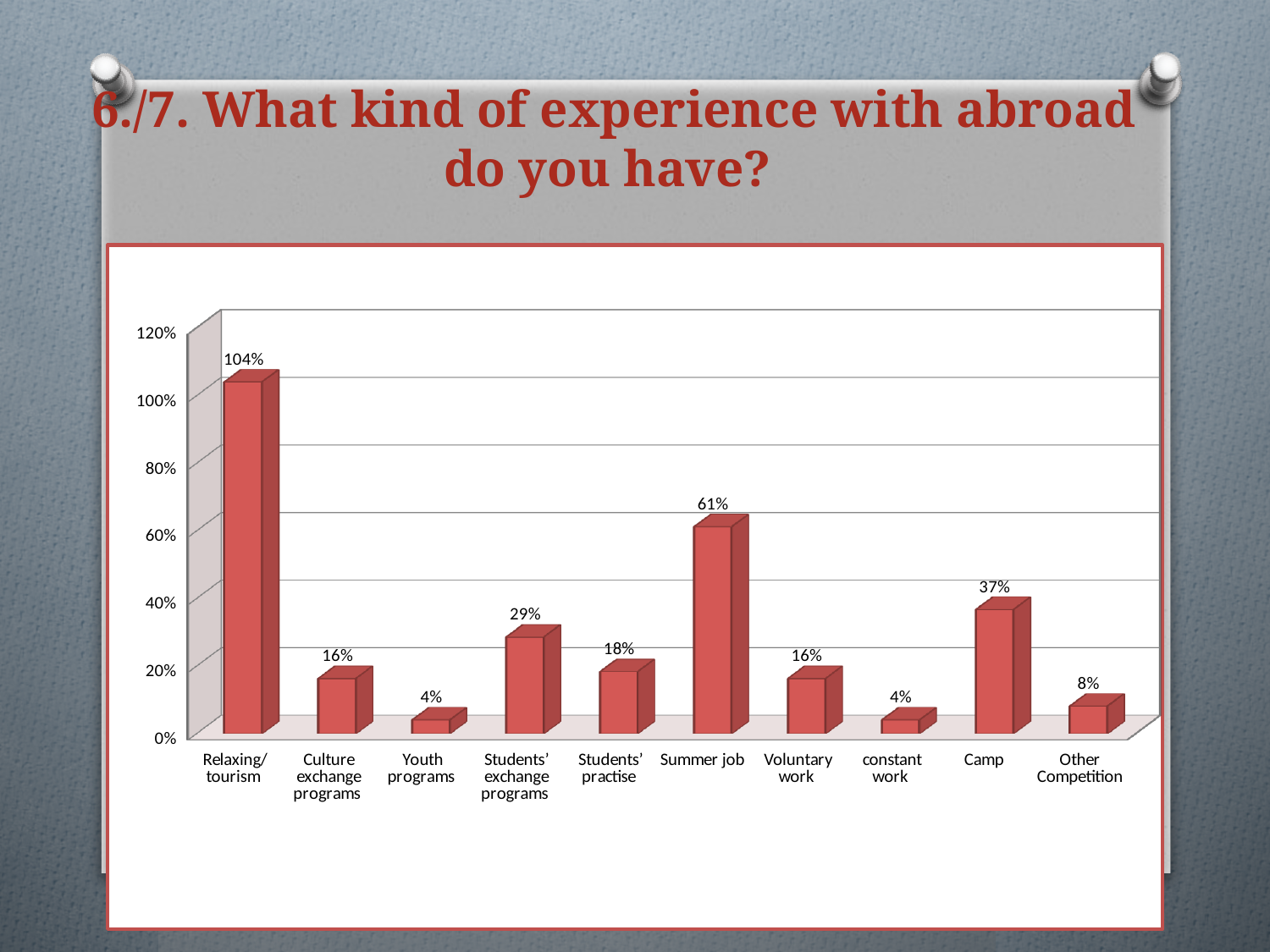
What is the difference between the values for Students' exchange programs and Students' practise? 11% Which category has the highest value? Relaxing/tourism What is the value for Relaxing/tourism? 104% What is the difference between the values for Summer job and Camp? 24% What is the value for Summer job? 61% Which is larger, the value for Culture exchange programs or the value for Students' practise? Students' practise How many categories are shown on the x axis? 10 Is the value for Summer job greater or less than 80%? less What is the value for Camp? 37% What is the value for Other Competition? 8% What is the value for Students' exchange programs? 29% What kind of chart is shown on the slide? Bar chart